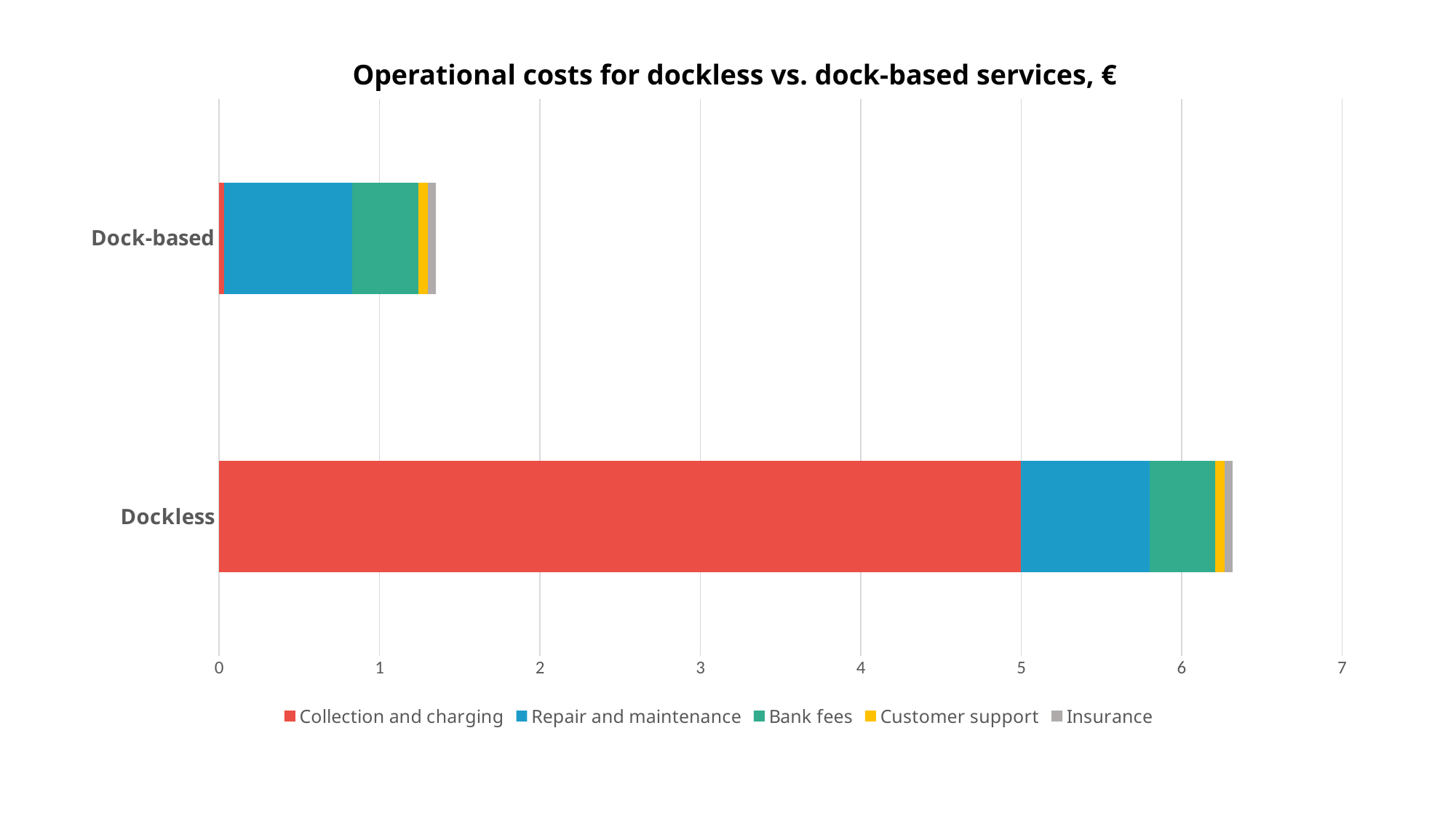
Is the total operational cost for Dock-based greater or less than 2? less Which category has the higher total operational cost, Dockless or Dock-based? Dockless Is the Repair and maintenance cost for Dock-based greater or less than 1? less How many series does the legend list? 5 Which category has the lowest total operational cost? Dock-based Is the total operational cost for Dockless greater or less than 6? greater Which series makes up the largest part of the Dockless bar? Collection and charging What kind of chart is shown on the slide? Stacked bar chart Which series is shown in yellow in the legend? Customer support How many categories are plotted on the chart? 2 What is the title of the chart? Operational costs for dockless vs. dock-based services, €